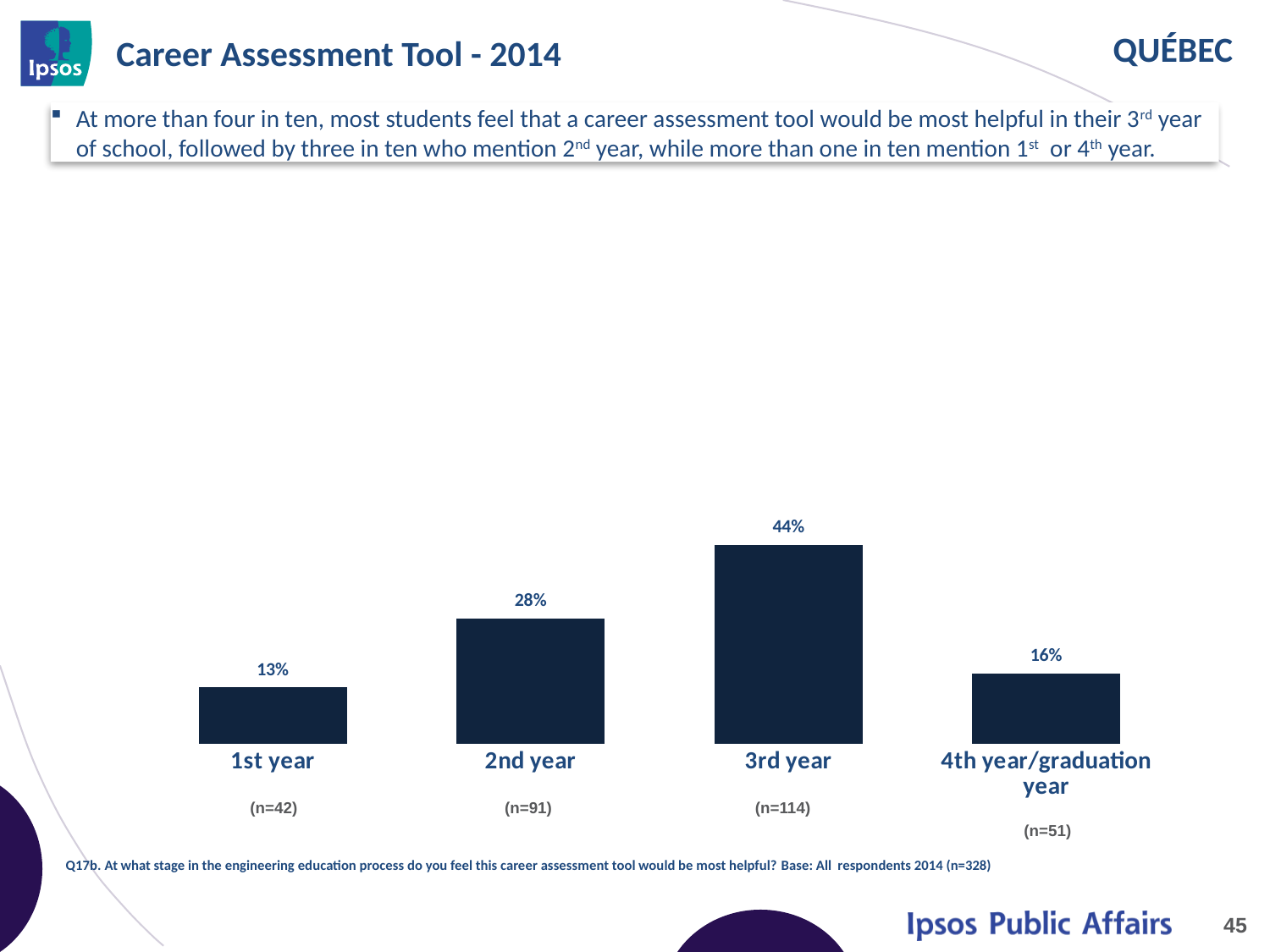
Which is larger, the value for 2nd year or the value for 4th year/graduation year? 2nd year Which year has the lowest percentage? 1st year Which year has the highest percentage? 3rd year What is the difference in percentage points between 4th year/graduation year and 1st year? 3 What is the difference in percentage points between 3rd year and 2nd year? 16 What is the value shown for 4th year/graduation year? 16% What percentage of students feel the career assessment tool would be most helpful in their 3rd year? 44% What kind of chart is shown on the slide? Bar chart What is the value shown for 2nd year? 28% How many categories are shown in the chart? 4 What is the value shown for 1st year? 13% What is the sample size (n) shown for the 3rd year category? n=114